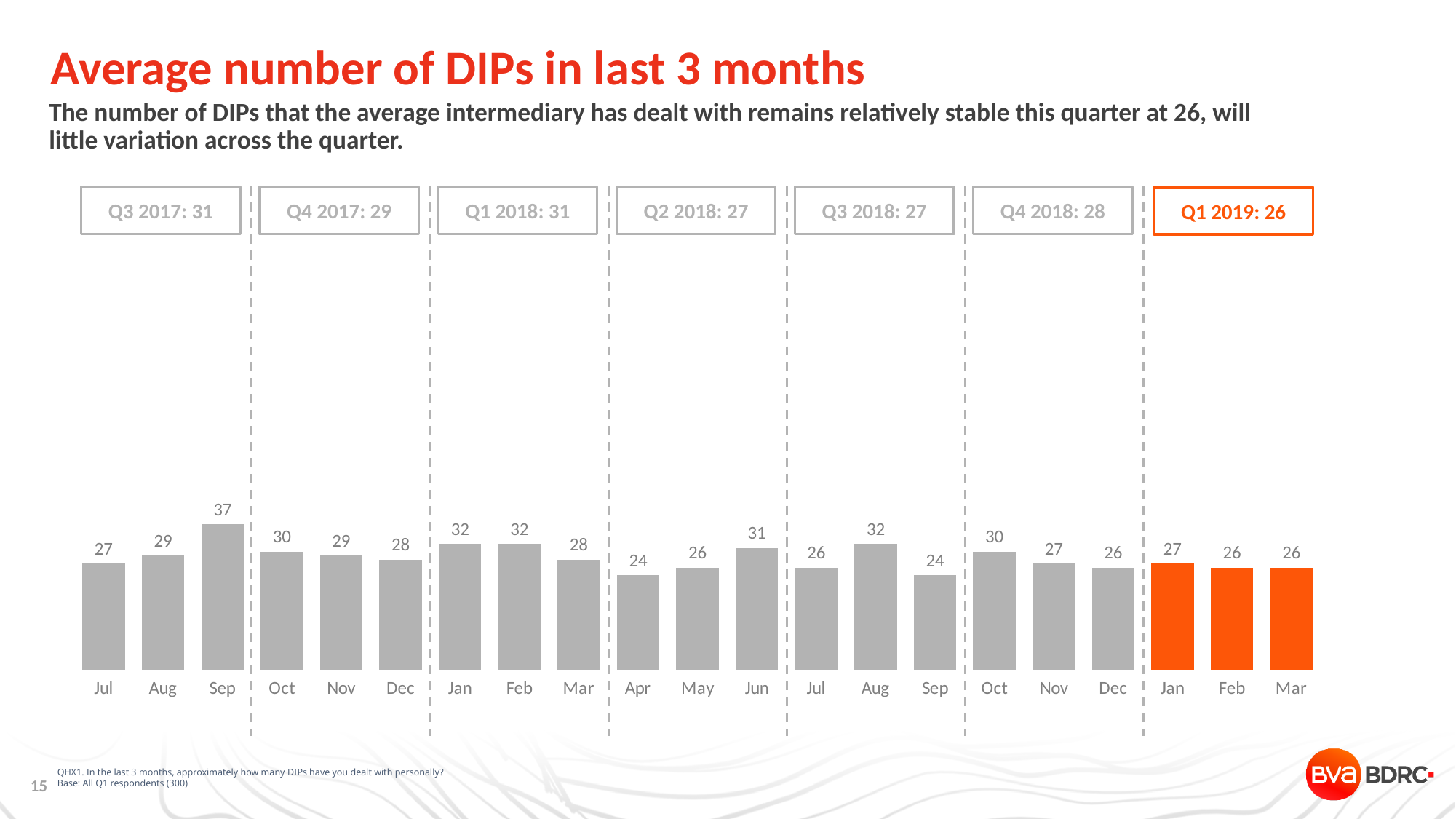
What is the value for Sep in the Q3 2017 section? 37 What is the lowest monthly value shown in the chart? 24 What is the value for Apr in the Q2 2018 section? 24 In the Q2 2018 section, which is larger, the value for Apr or the value for Jun? Jun What is the quarterly average shown in the box for Q1 2019? 26 How many monthly bars are plotted in the chart? 21 Which quarter's bars are highlighted in orange? Q1 2019 What kind of chart is shown on the slide? Bar chart Which month has the highest bar in the chart? Sep (Q3 2017) What is the difference between the Sep and Jul values in the Q3 2017 section? 10 What is the value for Jan in the Q1 2019 section? 27 What is the difference between the Aug and Sep values in the Q3 2018 section? 8